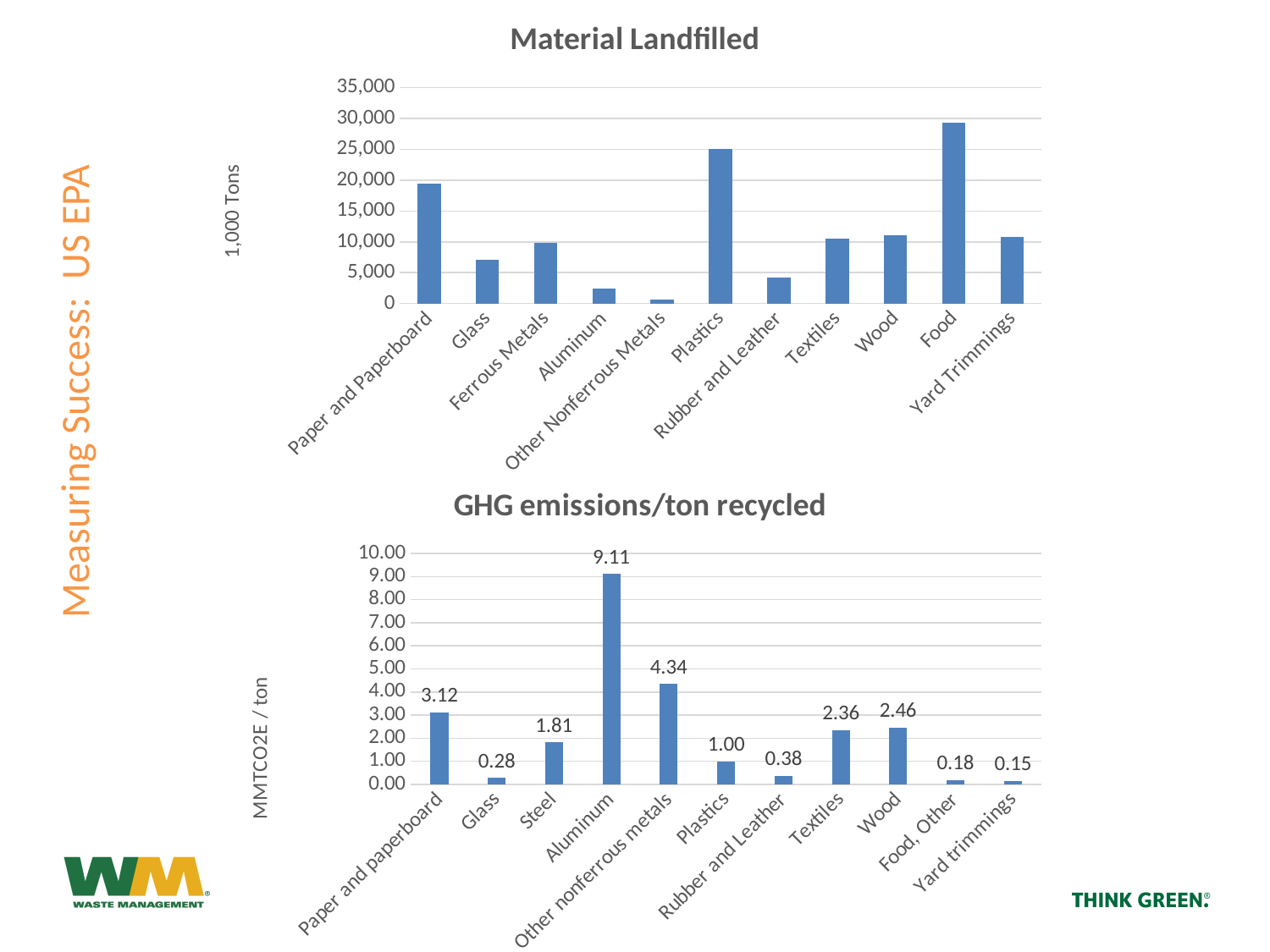
In the 'GHG emissions/ton recycled' chart, what is the difference between Aluminum and Other nonferrous metals? 4.77 In the 'GHG emissions/ton recycled' chart, what is the value for Rubber and Leather? 0.38 What is the y-axis unit label of the 'GHG emissions/ton recycled' chart? MMTCO2E / ton How many categories are shown in the 'Material Landfilled' chart? 11 In the 'GHG emissions/ton recycled' chart, what is the value for Paper and paperboard? 3.12 In the 'GHG emissions/ton recycled' chart, which category has the lowest value? Yard trimmings In the 'Material Landfilled' chart, is the value for Glass greater or less than 10,000? less In the 'GHG emissions/ton recycled' chart, what is the value for Aluminum? 9.11 In the 'Material Landfilled' chart, which category has the lowest value? Other Nonferrous Metals In the 'GHG emissions/ton recycled' chart, which is larger, Textiles or Wood? Wood In the 'Material Landfilled' chart, is the value for Plastics greater or less than 20,000? greater In the 'Material Landfilled' chart, which category has the highest value? Food